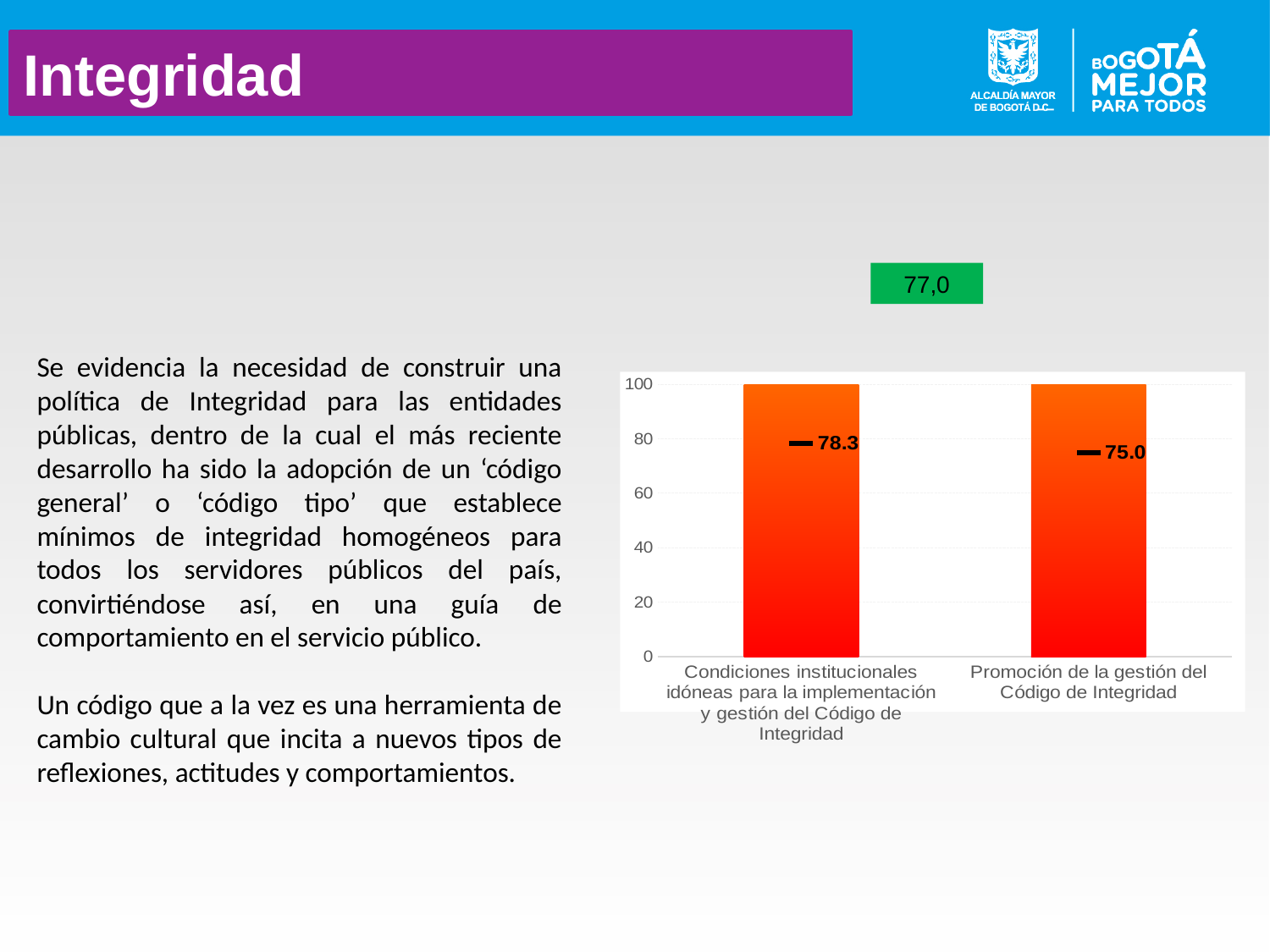
What value is shown for 'Condiciones institucionales idóneas para la implementación y gestión del Código de Integridad'? 78.3 How many categories are shown on the x axis of the chart? 2 Which category has the higher labelled value? Condiciones institucionales idóneas para la implementación y gestión del Código de Integridad What value is displayed in the green box above the chart? 77,0 Is the labelled value for 'Promoción de la gestión del Código de Integridad' greater or less than 80? less What is the difference between the labelled values of the two categories? 3.3 Which category has the lower labelled value? Promoción de la gestión del Código de Integridad What is the maximum value shown on the chart's vertical axis? 100 What kind of chart is shown on the slide? bar chart What value is shown for 'Promoción de la gestión del Código de Integridad'? 75.0 Is the labelled value for 'Promoción de la gestión del Código de Integridad' larger or smaller than that for 'Condiciones institucionales idóneas para la implementación y gestión del Código de Integridad'? smaller